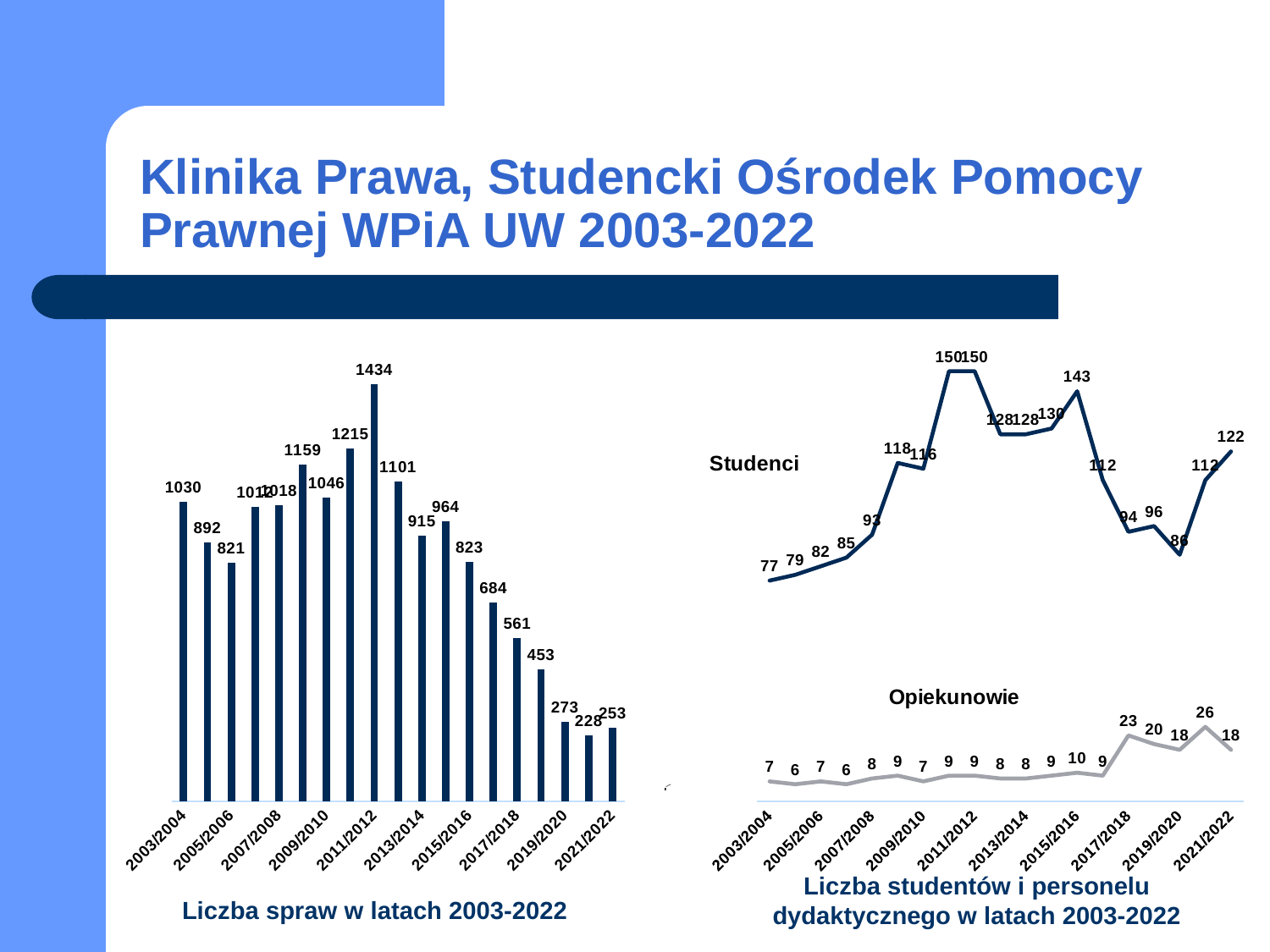
In the chart 'Liczba spraw w latach 2003-2022', do the values rise or fall from 2011/2012 to 2020/2021? fall In the right chart 'Liczba studentów i personelu dydaktycznego w latach 2003-2022', is the Studenci value larger in 2003/2004 or in 2021/2022? 2021/2022 In the chart 'Liczba spraw w latach 2003-2022', which year has the lowest number of cases? 2020/2021 In the right chart 'Liczba studentów i personelu dydaktycznego w latach 2003-2022', what is the highest Studenci value? 150 In the chart 'Liczba spraw w latach 2003-2022', what is the difference between the values for 2003/2004 and 2021/2022? 777 In the chart 'Liczba spraw w latach 2003-2022', which year has the highest number of cases? 2011/2012 How many series are plotted in the right chart 'Liczba studentów i personelu dydaktycznego w latach 2003-2022'? 2 In the chart 'Liczba spraw w latach 2003-2022', what is the value for 2011/2012? 1434 In the right chart 'Liczba studentów i personelu dydaktycznego w latach 2003-2022', what is the Studenci value for 2021/2022? 122 In the right chart 'Liczba studentów i personelu dydaktycznego w latach 2003-2022', in which year is the Opiekunowie value highest? 2020/2021 How many bars are shown in the chart 'Liczba spraw w latach 2003-2022'? 19 What kind of chart is the left chart titled 'Liczba spraw w latach 2003-2022'? bar chart